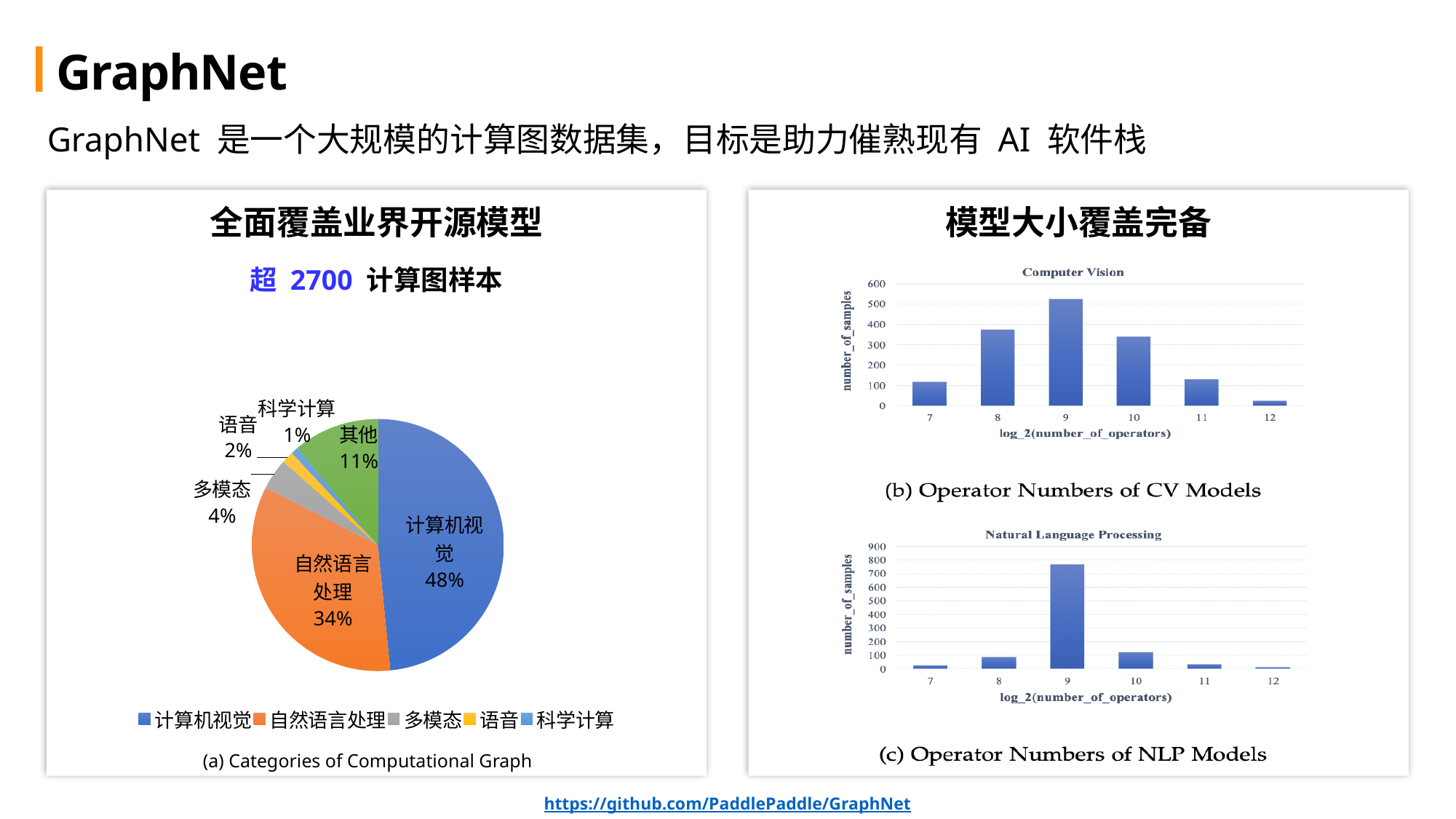
In the Computer Vision bar chart, which log_2(number_of_operators) value has the highest number of samples? 9 In the pie chart (a) Categories of Computational Graph, which is larger, 多模态 or 语音? 多模态 In the Natural Language Processing bar chart, how many bars are plotted? 6 In the Computer Vision bar chart, which log_2(number_of_operators) value has the lowest number of samples? 12 In the pie chart (a) Categories of Computational Graph, what is the difference between the shares of 计算机视觉 and 自然语言处理? 14% In the pie chart (a) Categories of Computational Graph, what share does 计算机视觉 have? 48% In the pie chart (a) Categories of Computational Graph, how many entries does the legend list? 5 In the pie chart (a) Categories of Computational Graph, which category has the smallest share? 科学计算 In the pie chart (a) Categories of Computational Graph, what share does 自然语言处理 have? 34% In the Computer Vision bar chart, is the number of samples at log_2(number_of_operators) = 9 greater or less than 500? greater In the Natural Language Processing bar chart, is the number of samples at log_2(number_of_operators) = 9 greater or less than 700? greater What kind of chart is the Computer Vision chart on the right side of the slide? bar chart